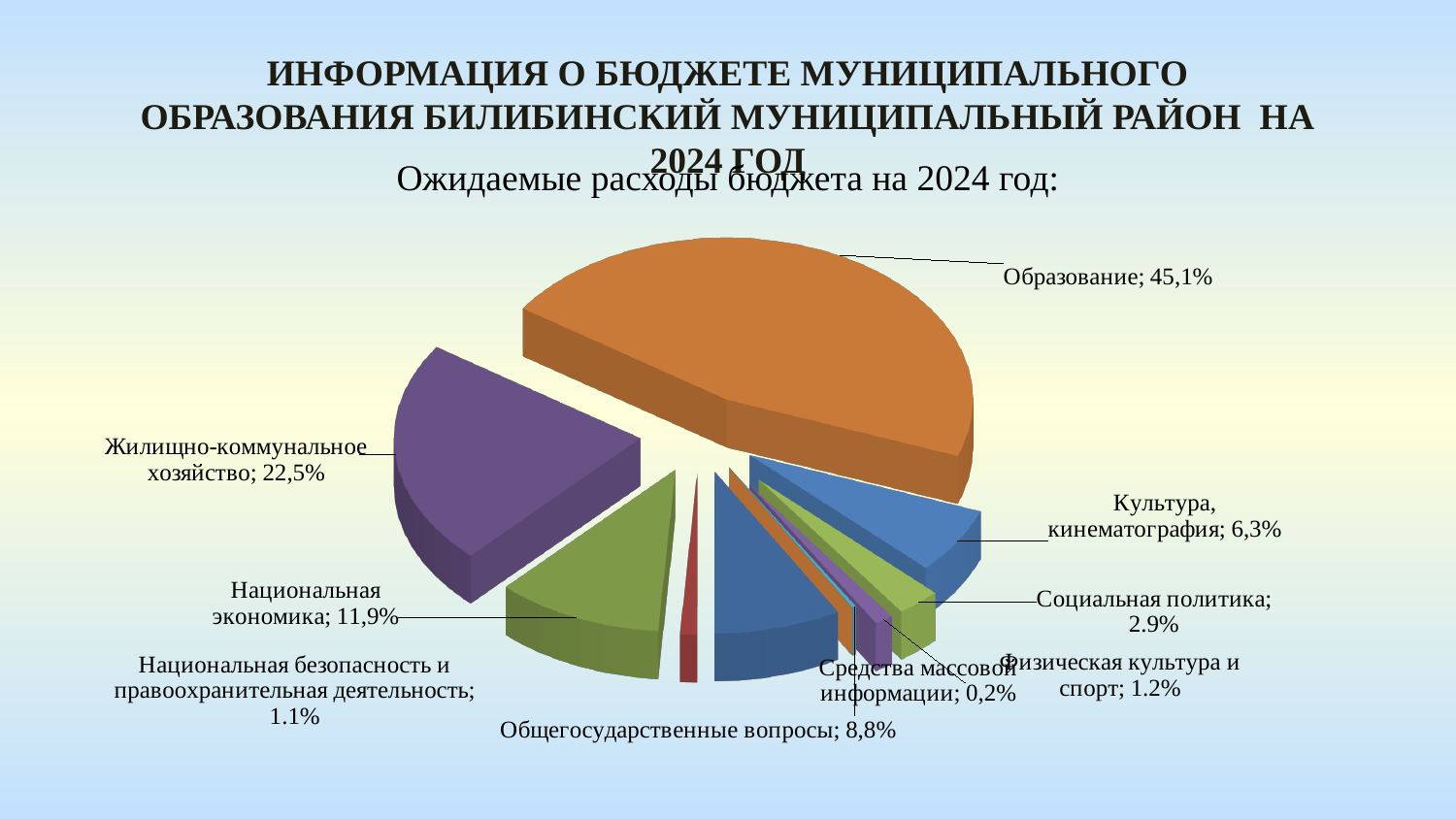
What is the value shown for Жилищно-коммунальное хозяйство? 22,5% Which category has the smallest share of the pie? Средства массовой информации Which category has the largest share of the pie? Образование What is the difference between the shares of Образование and Жилищно-коммунальное хозяйство? 22,6% Which is larger: Национальная экономика or Общегосударственные вопросы? Национальная экономика How many categories are shown in the pie chart? 9 What share is shown for Культура, кинематография? 6,3% What kind of chart is shown on the slide? pie chart What share of expected 2024 budget expenditures goes to Образование? 45,1% What percentage is shown for Общегосударственные вопросы? 8,8% What is the value for Средства массовой информации? 0,2% What is the title of the chart? Ожидаемые расходы бюджета на 2024 год: